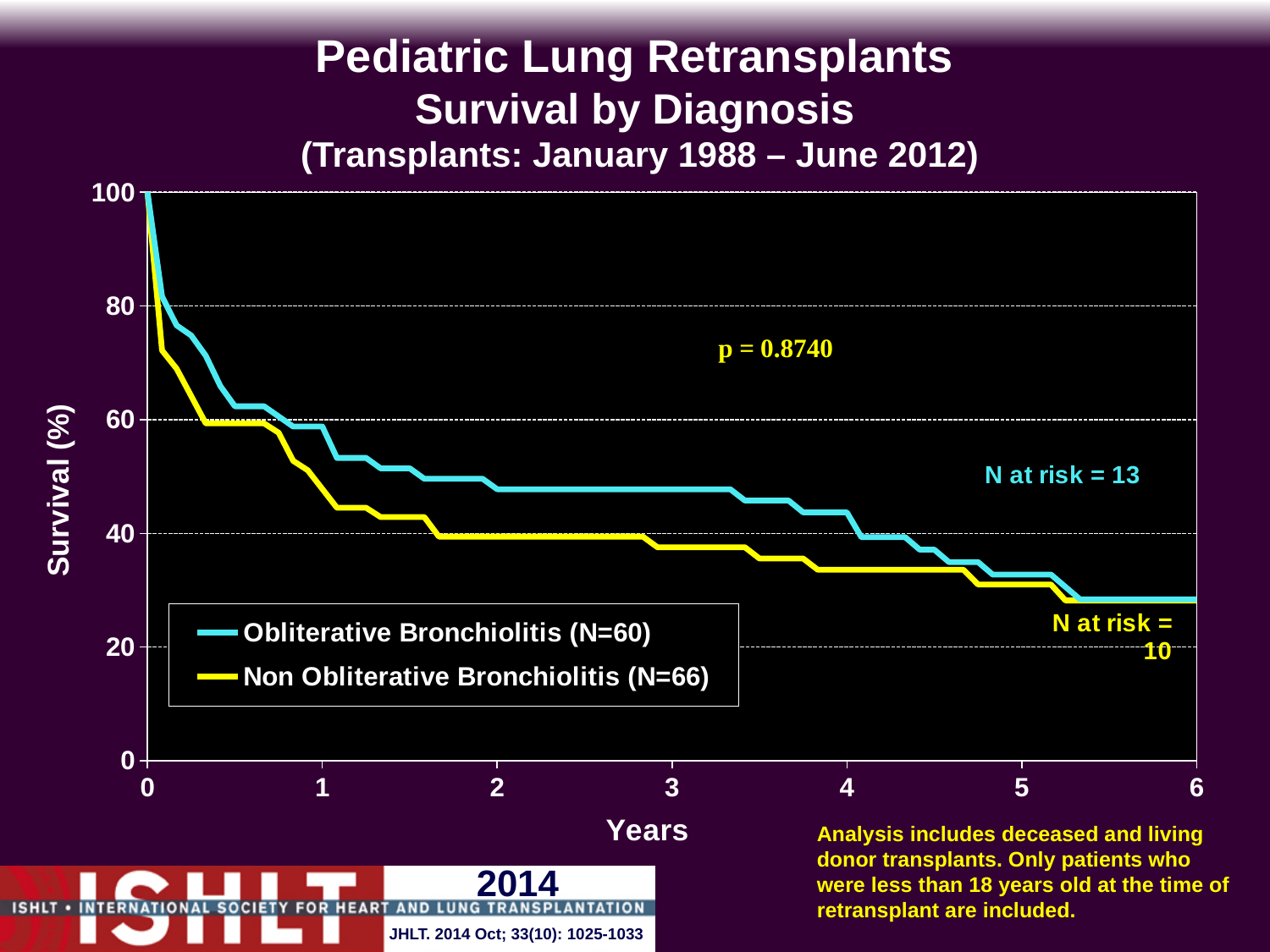
How many series does the legend list? 2 What kind of chart is shown on the slide? Line chart At 2 years, which group has the higher survival, Obliterative Bronchiolitis or Non Obliterative Bronchiolitis? Obliterative Bronchiolitis Do the survival curves rise or fall as years increase? Fall What is the N at risk for the Non Obliterative Bronchiolitis group shown on the chart? 10 Is the survival for Non Obliterative Bronchiolitis at 1 year greater or less than 60%? less Is the survival for Obliterative Bronchiolitis at 2 years greater or less than 40%? greater Is the survival for Obliterative Bronchiolitis at 6 years greater or less than 40%? less How many patients (N) are in the Non Obliterative Bronchiolitis group according to the legend? 66 What is the N at risk for the Obliterative Bronchiolitis group shown on the chart? 13 What is the p-value printed on the chart? p = 0.8740 What is the label of the y axis? Survival (%)